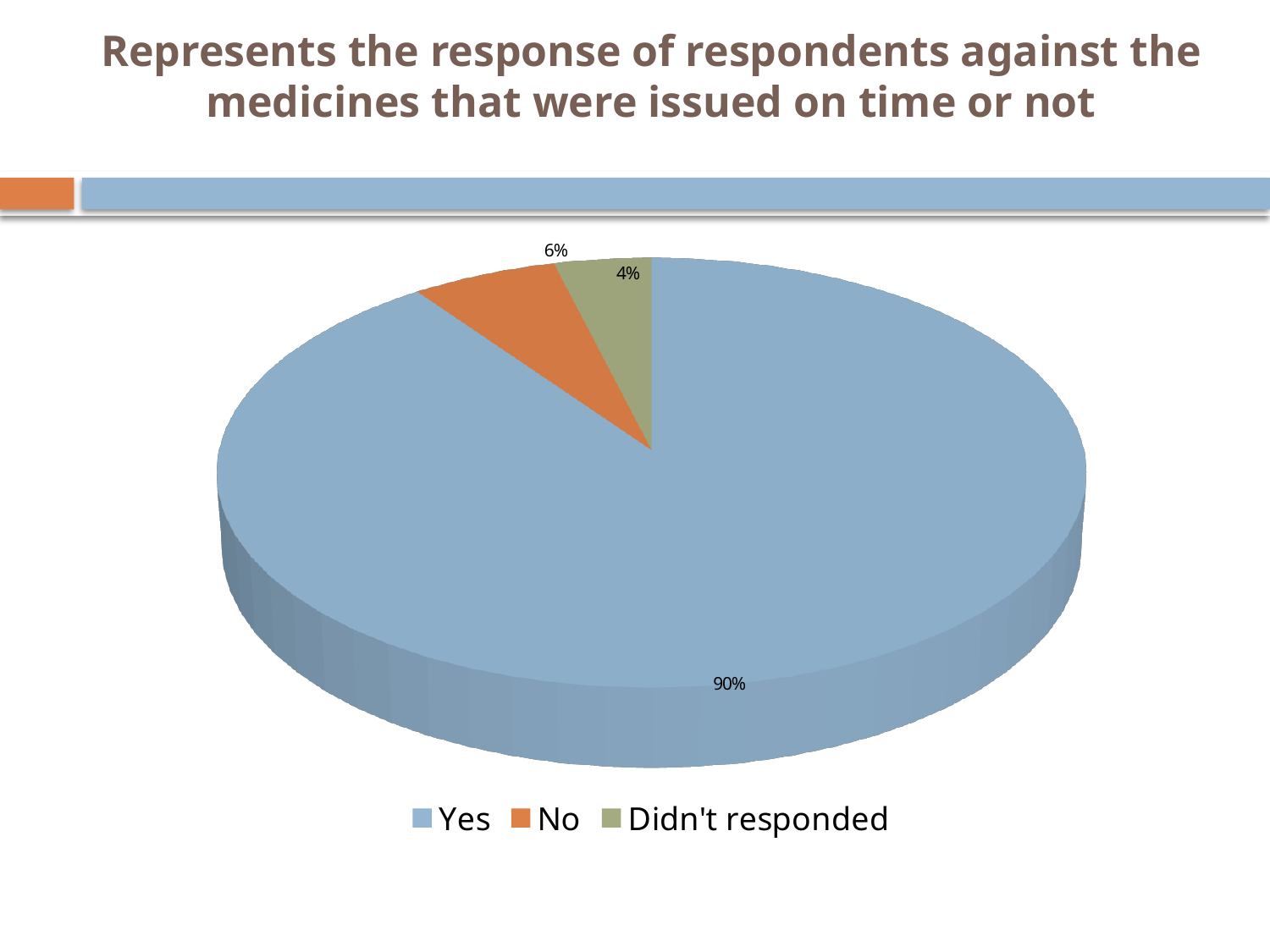
Which category has the largest share of the pie? Yes How many slices does the pie chart have? 3 What percentage of respondents didn't respond? 4% What is the difference in percentage points between the No and Didn't responded slices? 2 What is the difference in percentage points between the Yes and No slices? 84 How many entries does the legend list? 3 What kind of chart is shown on the slide? pie chart Which category has the smallest share of the pie? Didn't responded What percentage of respondents answered Yes? 90% Which is larger, the No slice or the Didn't responded slice? No What colour is the Yes slice? blue What percentage of respondents answered No? 6%